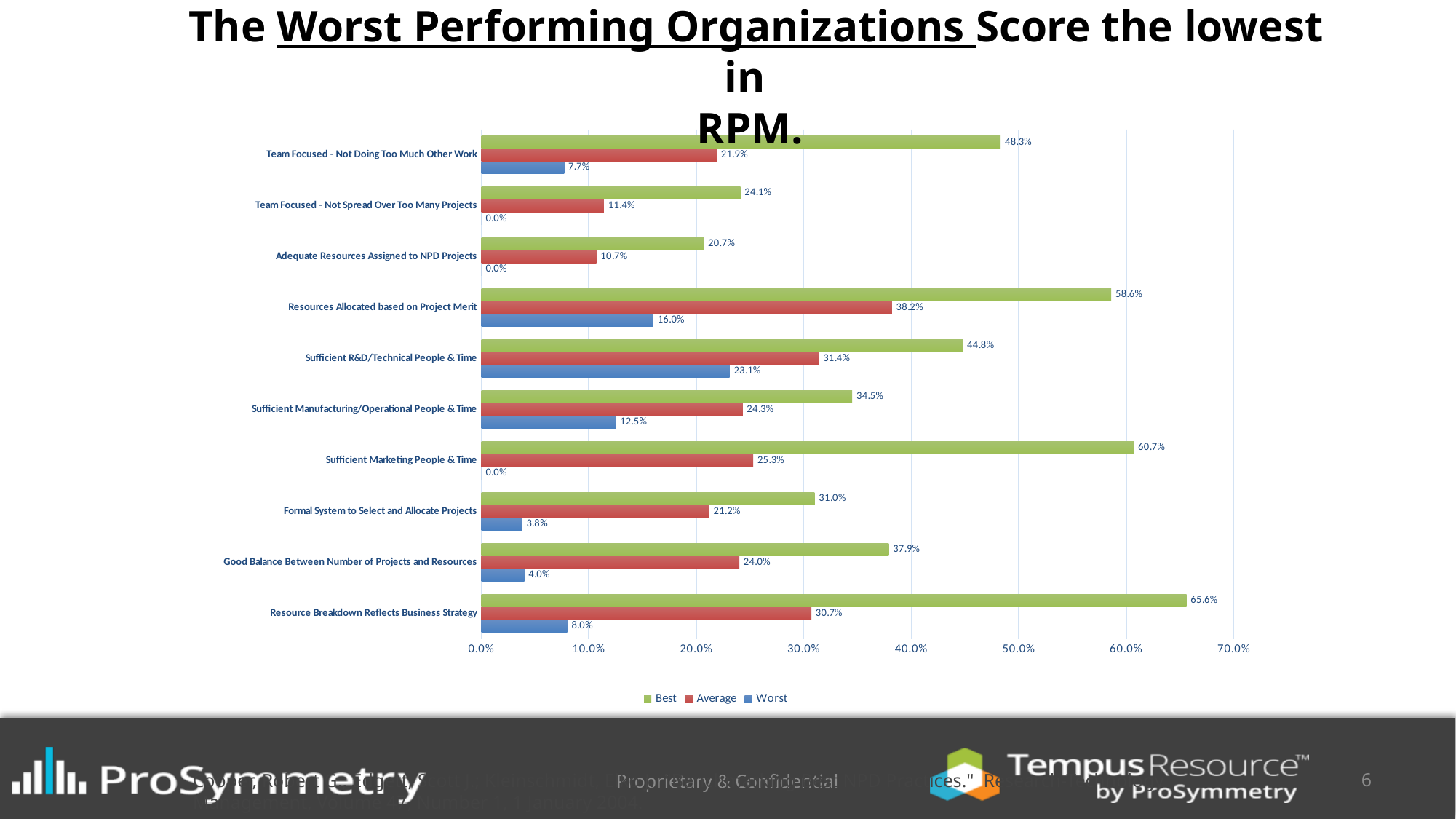
Which category has the lowest Best value? Adequate Resources Assigned to NPD Projects How many series does the legend list? 3 Which category has the highest Best value? Resource Breakdown Reflects Business Strategy Is the Best value for Resources Allocated based on Project Merit greater or less than 50.0%? greater What is the difference between the Best and Worst values for Resource Breakdown Reflects Business Strategy? 57.6% What kind of chart is shown on the slide? bar chart What is the Best value for Resource Breakdown Reflects Business Strategy? 65.6% What is the Average value for Resources Allocated based on Project Merit? 38.2% Which is larger, the Best value for Sufficient Marketing People & Time or the Best value for Resources Allocated based on Project Merit? Sufficient Marketing People & Time Which category has the highest Worst value? Sufficient R&D/Technical People & Time What is the Worst value for Sufficient R&D/Technical People & Time? 23.1% How many categories are plotted on the chart? 10